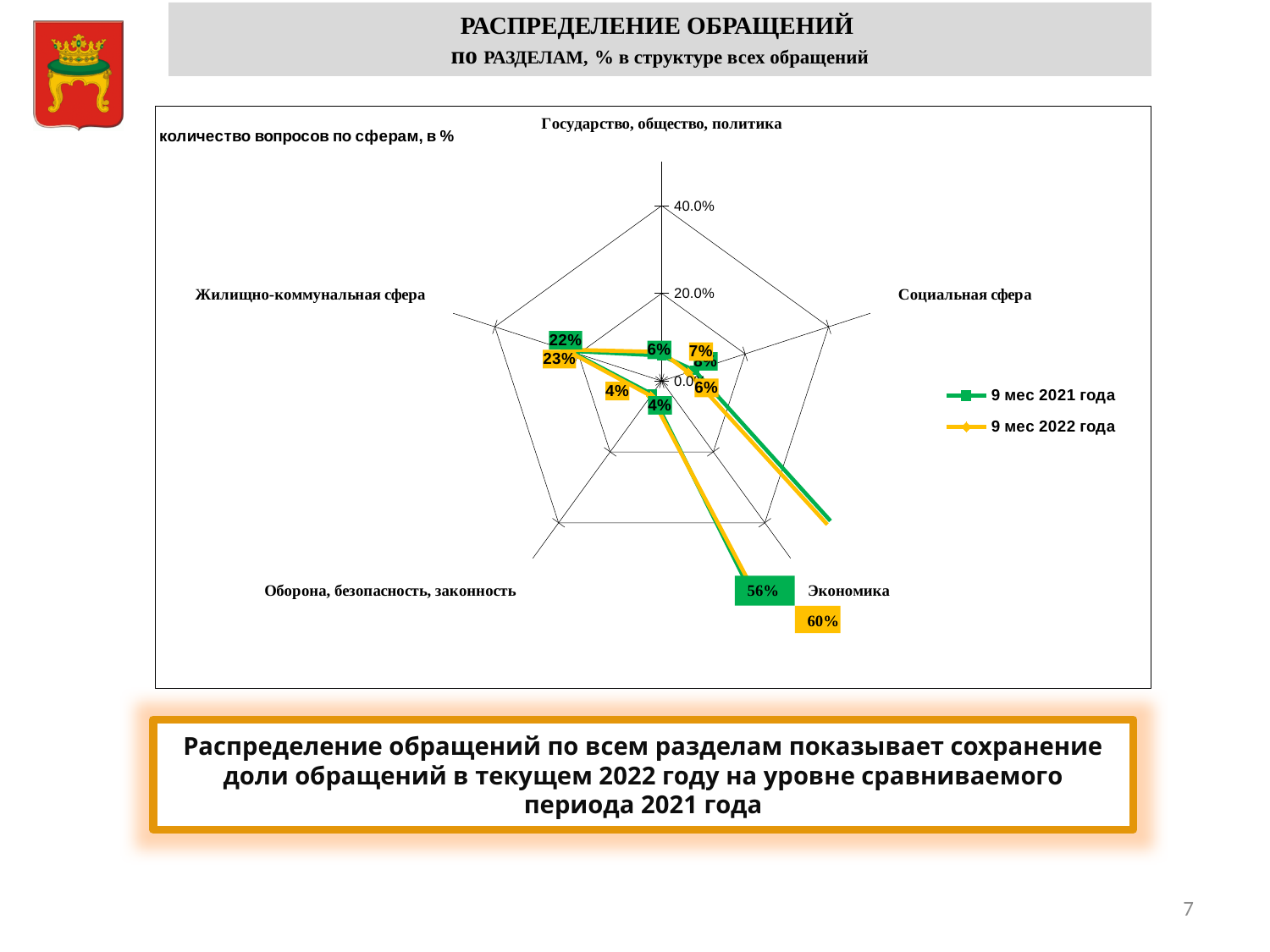
Which category has the highest value in the series 9 мес 2022 года? Экономика Which is larger: the Экономика value for 9 мес 2021 года or for 9 мес 2022 года? 9 мес 2022 года What is the difference between the Экономика values for 9 мес 2022 года and 9 мес 2021 года? 4% What is the value for Жилищно-коммунальная сфера in the series 9 мес 2021 года? 22% What is the value for Жилищно-коммунальная сфера in the series 9 мес 2022 года? 23% What is the value for Экономика in the series 9 мес 2021 года? 56% What is the value for Экономика in the series 9 мес 2022 года? 60% What kind of chart is shown on the slide? radar chart What is the value for Оборона, безопасность, законность in the series 9 мес 2022 года? 4% How many series does the legend list? 2 How many categories (axes) does the radar chart have? 5 What are the two legend entries of the chart? 9 мес 2021 года and 9 мес 2022 года